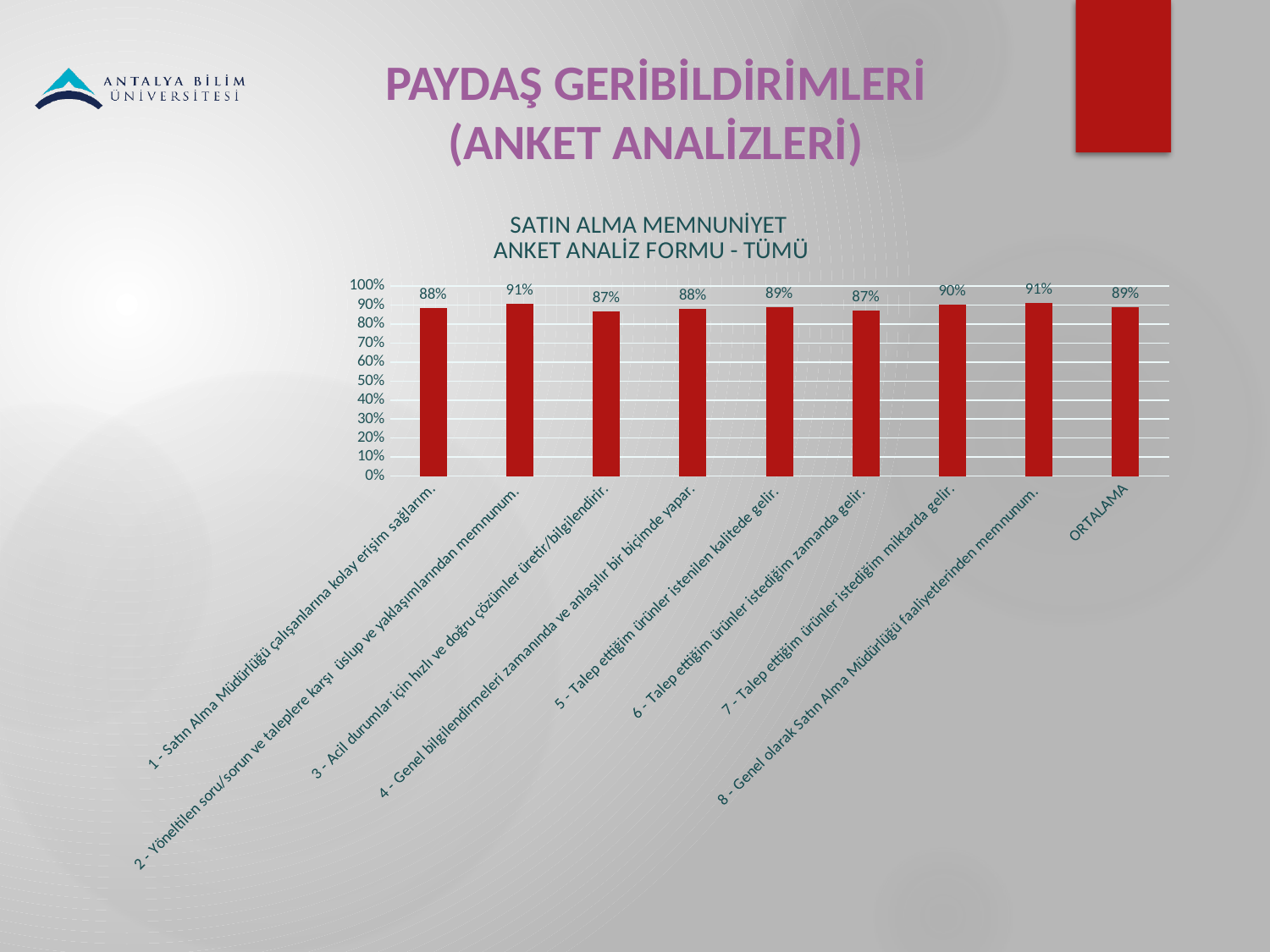
What is the value for "3 - Acil durumlar için hızlı ve doğru çözümler üretir/bilgilendirir."? 87% What is the difference between the value for "8 - Genel olarak Satın Alma Müdürlüğü faaliyetlerinden memnunum." and the value for "6 - Talep ettiğim ürünler istediğim zamanda gelir."? 4% What is the highest value shown in the chart? 91% What is the value for "7 - Talep ettiğim ürünler istediğim miktarda gelir."? 90% How many bars are shown in the chart? 9 What is the lowest value shown in the chart? 87% What is the title of the chart? SATIN ALMA MEMNUNİYET ANKET ANALİZ FORMU - TÜMÜ Which is larger: the value for "5 - Talep ettiğim ürünler istenilen kalitede gelir." or the value for "4 - Genel bilgilendirmeleri zamanında ve anlaşılır bir biçimde yapar."? 5 - Talep ettiğim ürünler istenilen kalitede gelir. Is the value for "1 - Satın Alma Müdürlüğü çalışanlarına kolay erişim sağlarım." greater or less than 80%? greater What is the value for "2 - Yöneltilen soru/sorun ve taleplere karşı üslup ve yaklaşımlarından memnunum."? 91% What is the value for ORTALAMA? 89% What kind of chart is shown on the slide? bar chart